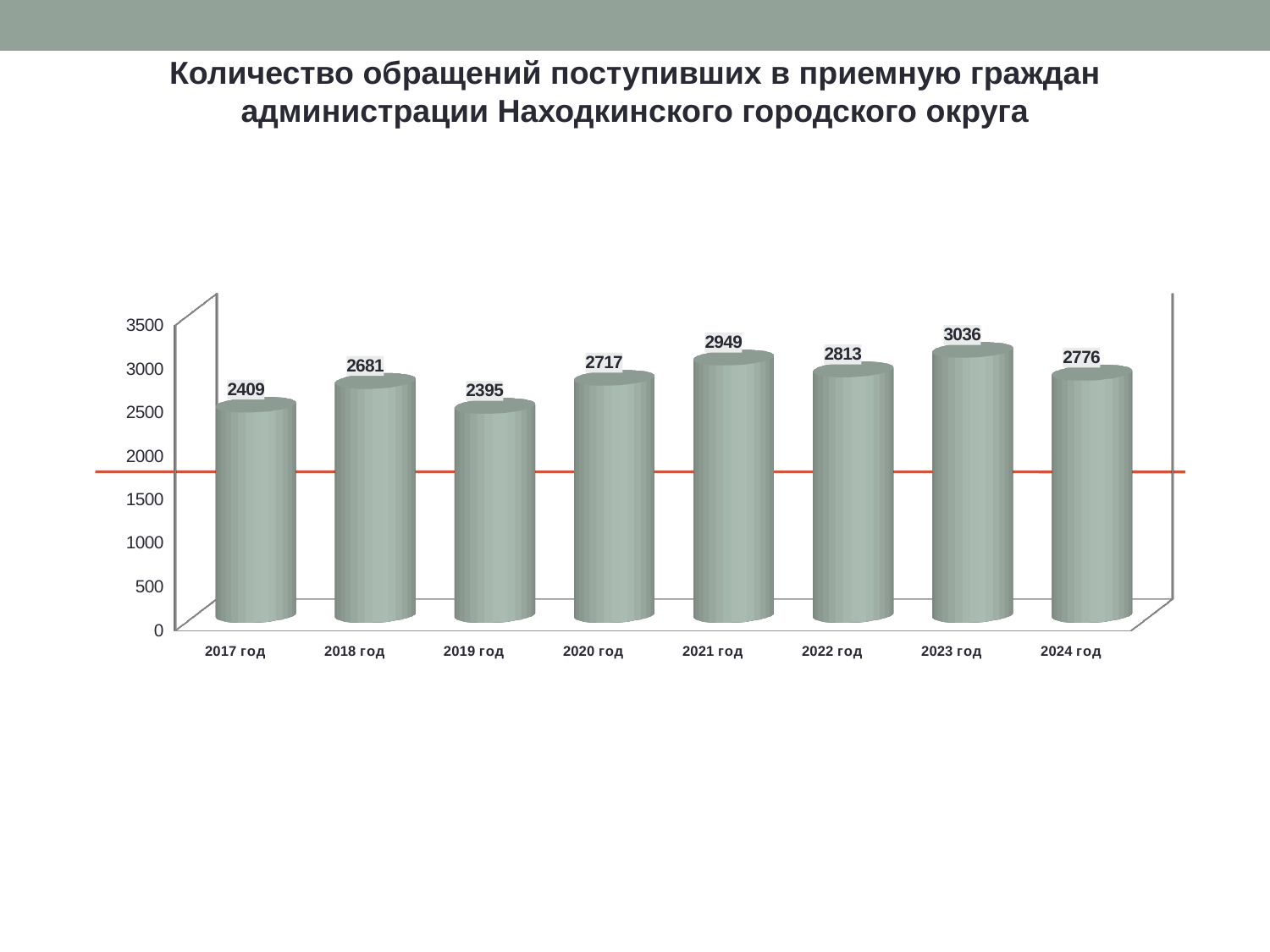
What is the difference between the values for 2023 год and 2024 год? 260 How many years are shown on the x axis? 8 What is the value for 2021 год? 2949 What is the difference between the values for 2018 год and 2019 год? 286 Which is larger, the value for 2020 год or the value for 2022 год? 2022 год What kind of chart is shown on the slide? bar chart Which year has the lowest value? 2019 год What is the value for 2024 год? 2776 What is the value for 2017 год? 2409 Which year has the highest value? 2023 год What is the title of the chart? Количество обращений поступивших в приемную граждан администрации Находкинского городского округа Is the value for 2023 год greater or less than 3000? greater